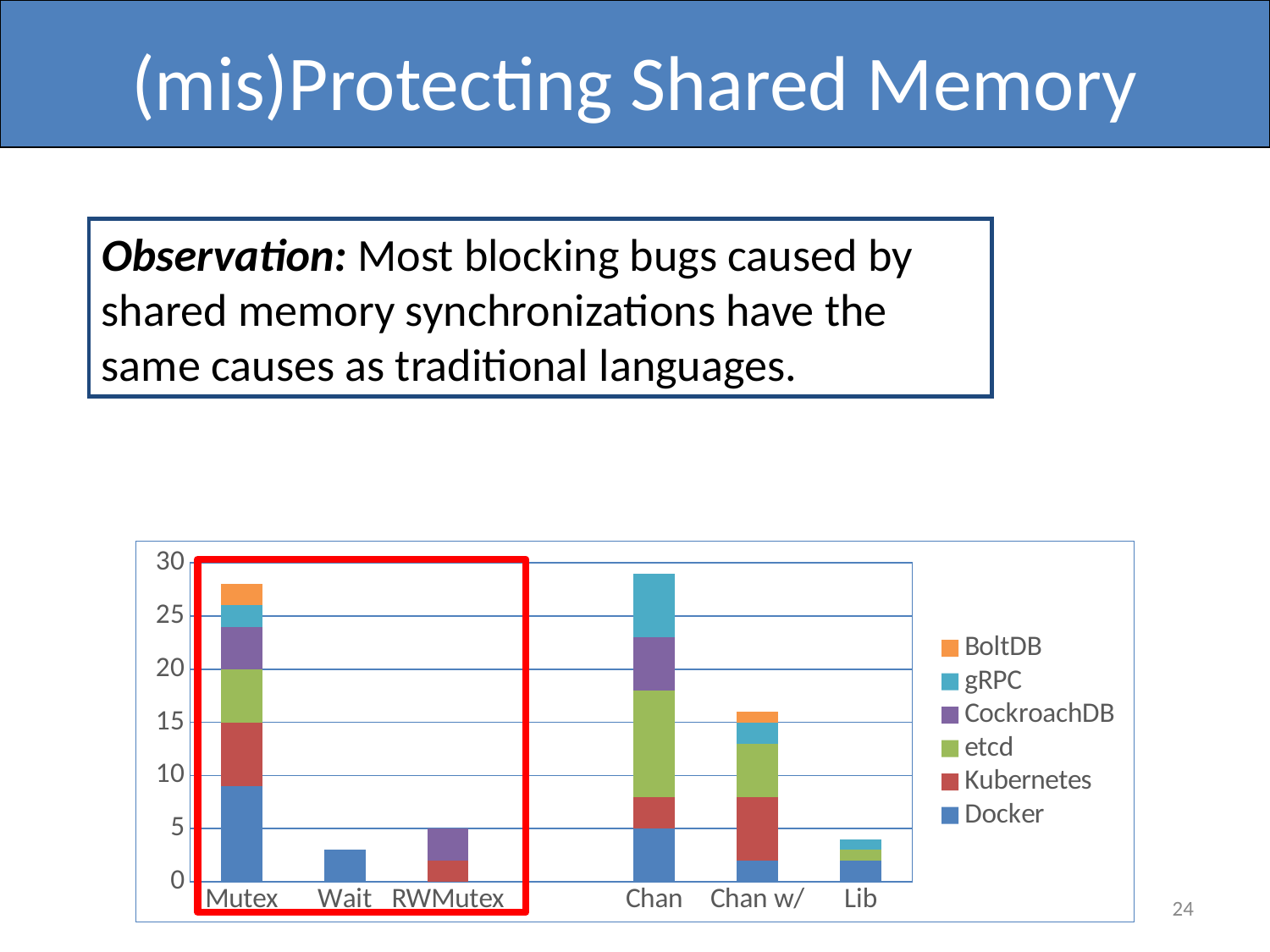
Is the total value for Mutex greater or less than 25? greater Is the total value for Chan greater or less than 25? greater Which has a larger total, Chan or Lib? Chan Which has a larger total, Mutex or Wait? Mutex Is the total value for Chan w/ greater or less than 10? greater How many labelled categories have bars in the chart? 6 Which has a larger total, Chan w/ or RWMutex? Chan w/ Which series is listed first (at the top) in the chart legend? BoltDB How many series does the chart legend list? 6 What kind of chart is shown on the slide? stacked bar chart